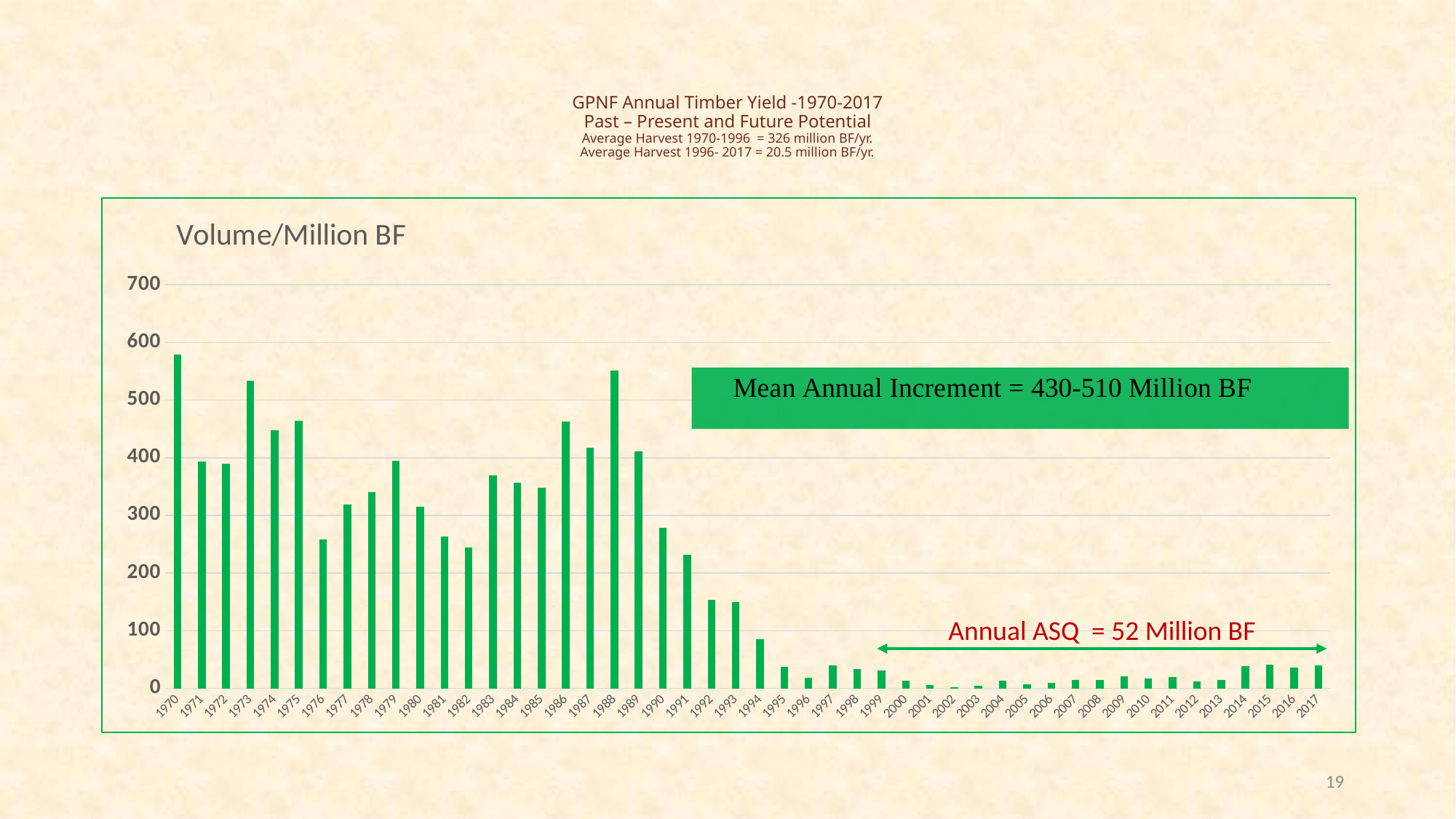
Is the value for 1970 greater or less than 500? greater What kind of chart is shown on the slide? Bar chart Is the value for 1976 greater or less than 300? less What is the title shown inside the chart area? Volume/Million BF Which year has the highest timber yield? 1970 Is the value for 1988 greater or less than 500? greater Overall, do the values rise or fall from 1970 to 2017? Fall Which year has the larger value, 1973 or 1974? 1973 How many years are plotted along the x axis? 48 Which year has the larger value, 1991 or 1992? 1991